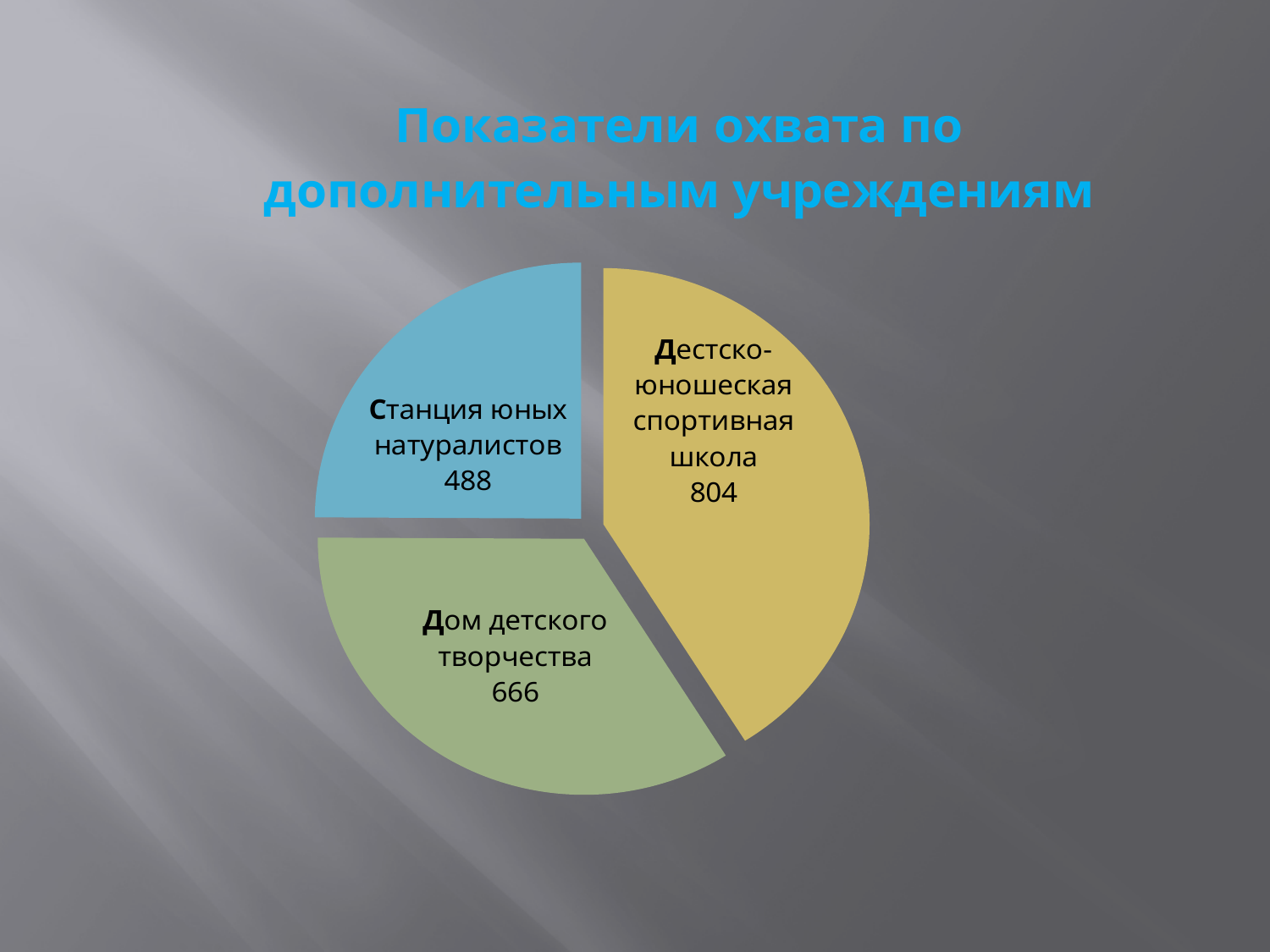
How many categories are shown in the pie chart? 3 What type of chart is shown on the slide? pie chart What is the difference between the values for Дестско-юношеская спортивная школа and Дом детского творчества? 138 Which category has the smallest slice of the pie? Станция юных натуралистов What is the value for Дестско-юношеская спортивная школа? 804 Which is larger: the value for Дом детского творчества or the value for Станция юных натуралистов? Дом детского творчества Which category has the largest slice of the pie? Дестско-юношеская спортивная школа What colour is the slice for Станция юных натуралистов? blue What is the title of the chart? Показатели охвата по дополнительным учреждениям What is the value for Станция юных натуралистов? 488 What is the difference between the values for Дом детского творчества and Станция юных натуралистов? 178 What is the value for Дом детского творчества? 666